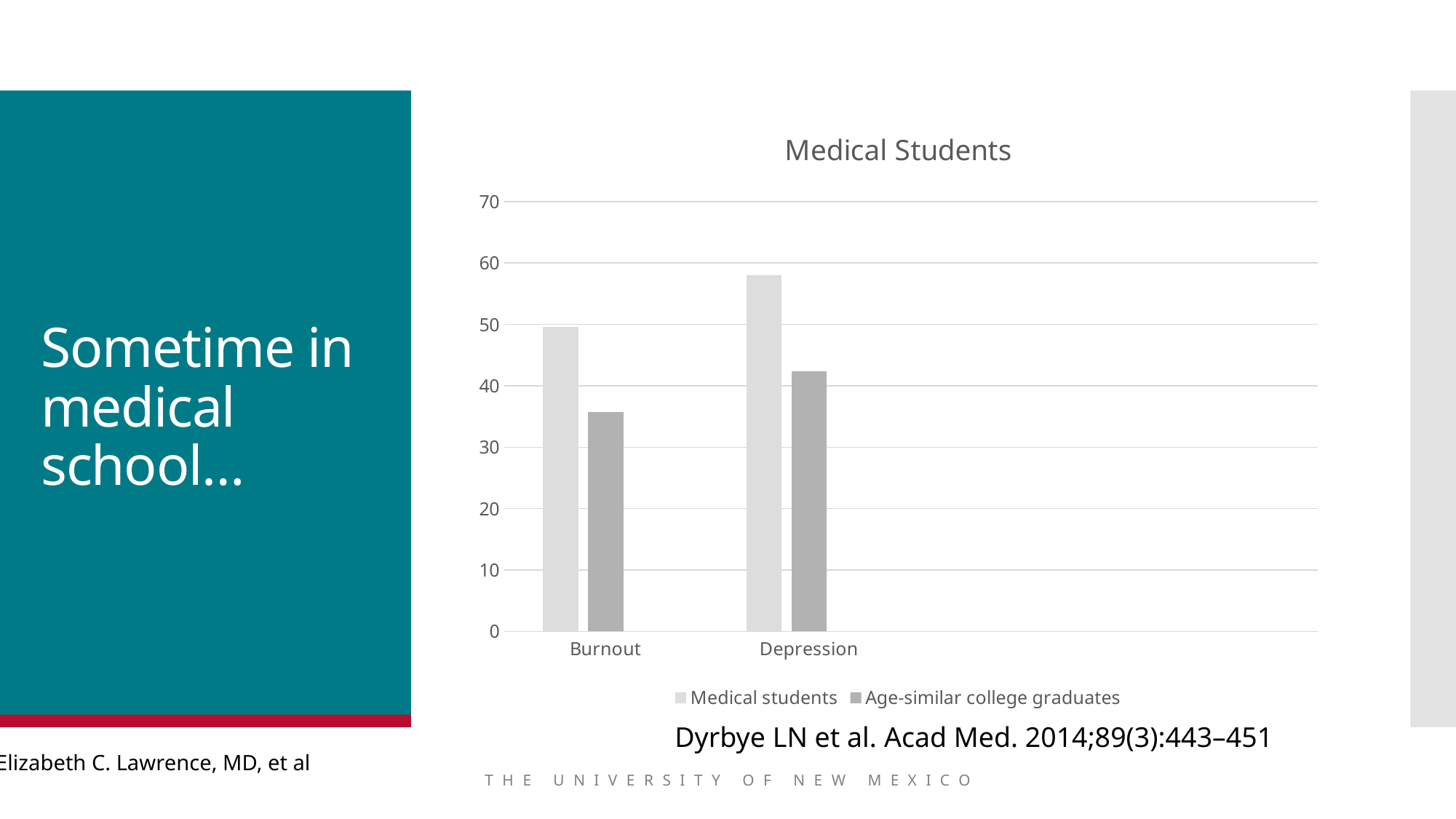
Which series is shown in the darker grey bars? Age-similar college graduates Is the value for Age-similar college graduates under Burnout greater or less than 40? less Is the value for Medical students under Depression greater or less than 50? greater Is the value for Medical students under Burnout greater or less than 40? greater Which bar is the lowest on the chart? Age-similar college graduates for Burnout How many series does the legend list? 2 What is the title of the chart? Medical Students What type of chart is shown on the slide? bar chart Which category has the highest bar for Medical students? Depression For Depression, which series has the larger value: Medical students or Age-similar college graduates? Medical students How many categories are shown on the x axis? 2